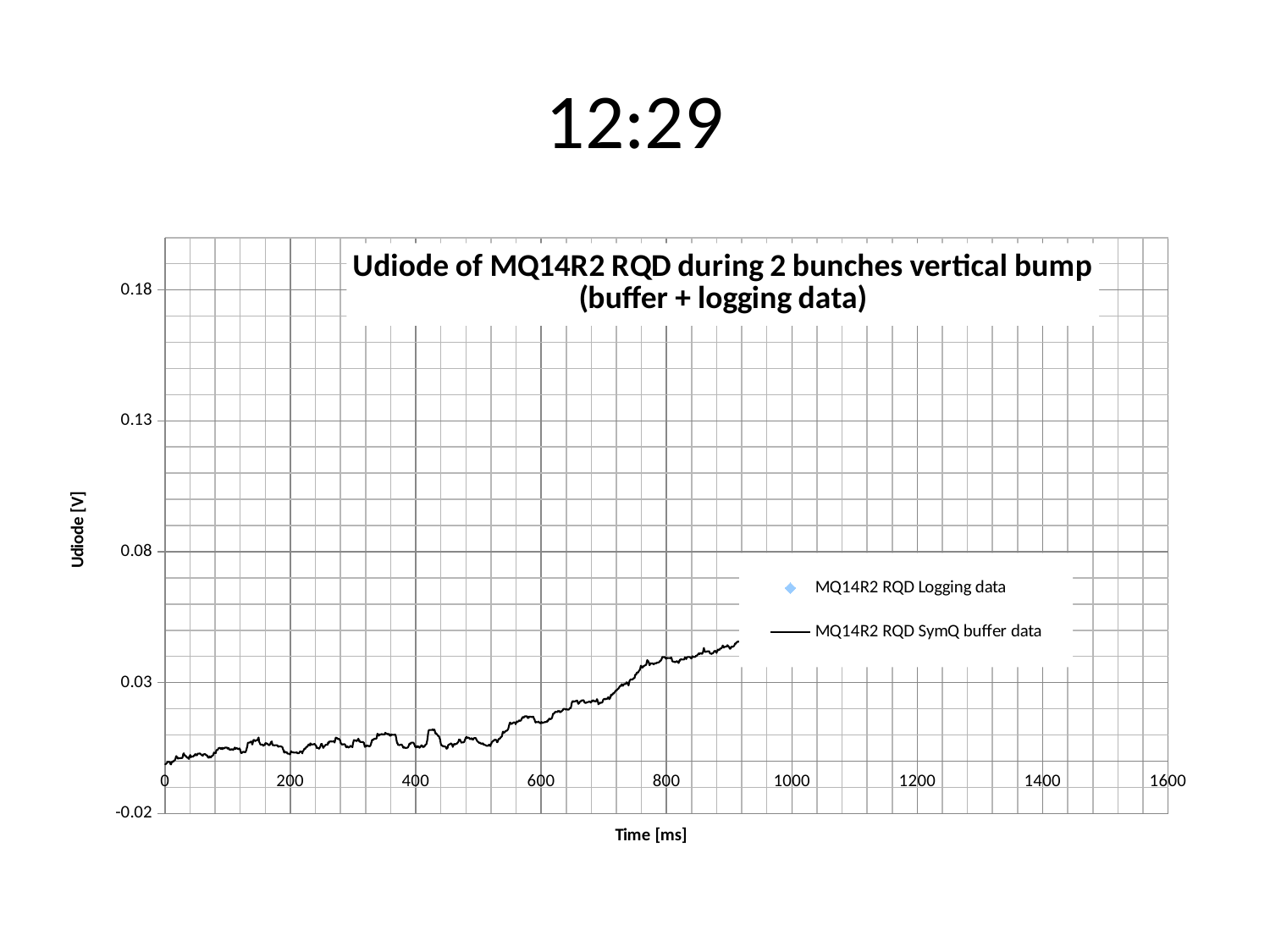
What is the label of the x axis? Time [ms] Is the value of the MQ14R2 RQD SymQ buffer data at 200 ms greater or less than 0.03? less What kind of chart is shown on the slide? line chart Which is larger for the MQ14R2 RQD SymQ buffer data: the value at 100 ms or the value at 900 ms? 900 ms How many series does the legend list? 2 Is the value of the MQ14R2 RQD SymQ buffer data at 900 ms greater or less than 0.08? less Is the value of the MQ14R2 RQD SymQ buffer data at 400 ms greater or less than 0.03? less What is the title of the chart? Udiode of MQ14R2 RQD during 2 bunches vertical bump (buffer + logging data) Does the SymQ buffer data line generally rise or fall as time increases? rise